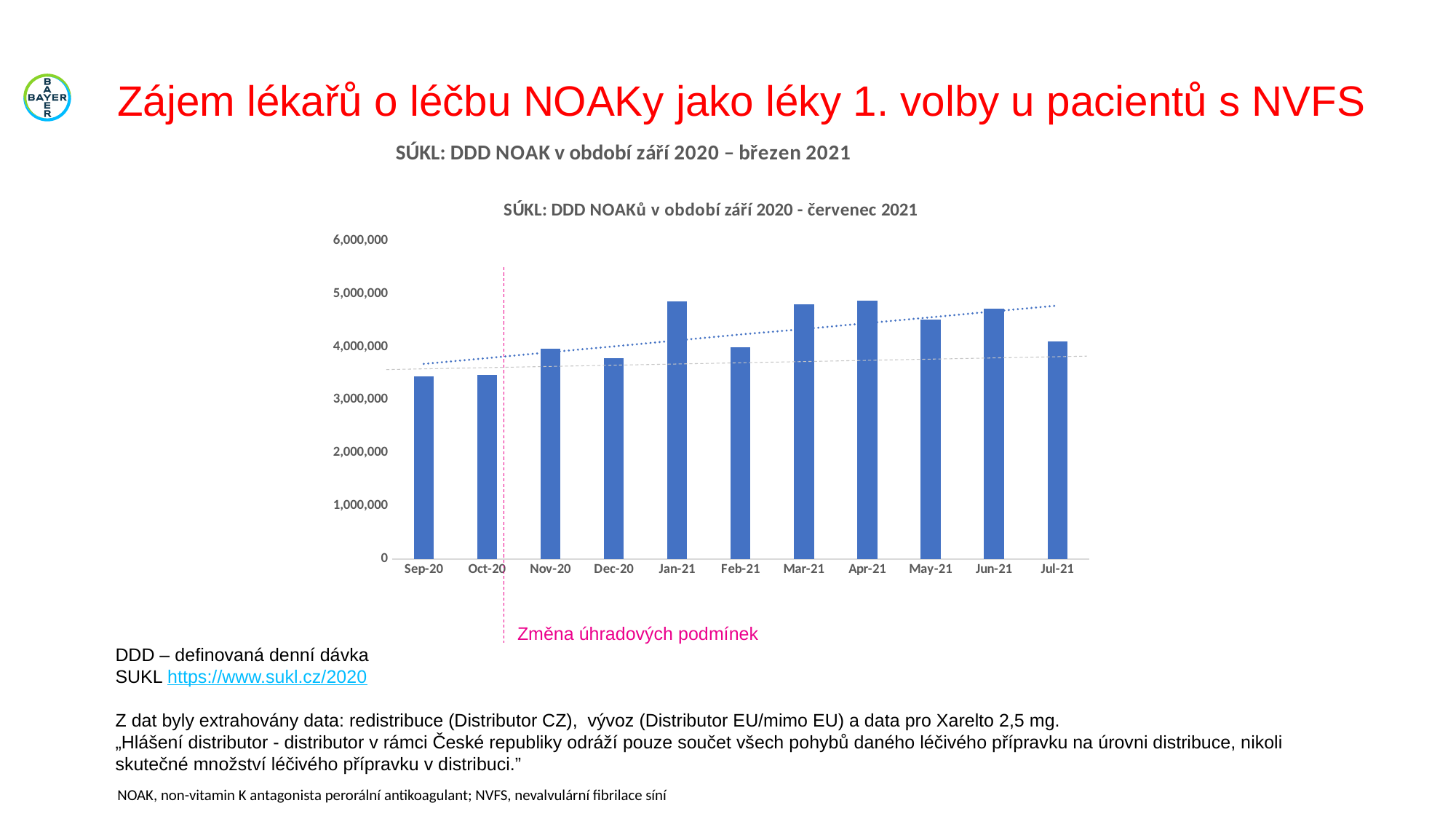
Is the value for Jul-21 greater or less than 5,000,000? less What label is attached to the dashed pink vertical line on the chart? Změna úhradových podmínek Which is larger, the value for Jan-21 or the value for Sep-20? Jan-21 According to the dotted trend line, do the values generally rise or fall from Sep-20 to Jul-21? rise What kind of chart is shown on the slide? bar chart What is the title printed above the chart's plot area? SÚKL: DDD NOAKů v období září 2020 - červenec 2021 Is the value for Jan-21 greater or less than 4,000,000? greater Is the value for Dec-20 greater or less than 4,000,000? less How many months (bars) are plotted on the chart? 11 Which is larger, the value for Jun-21 or the value for Jul-21? Jun-21